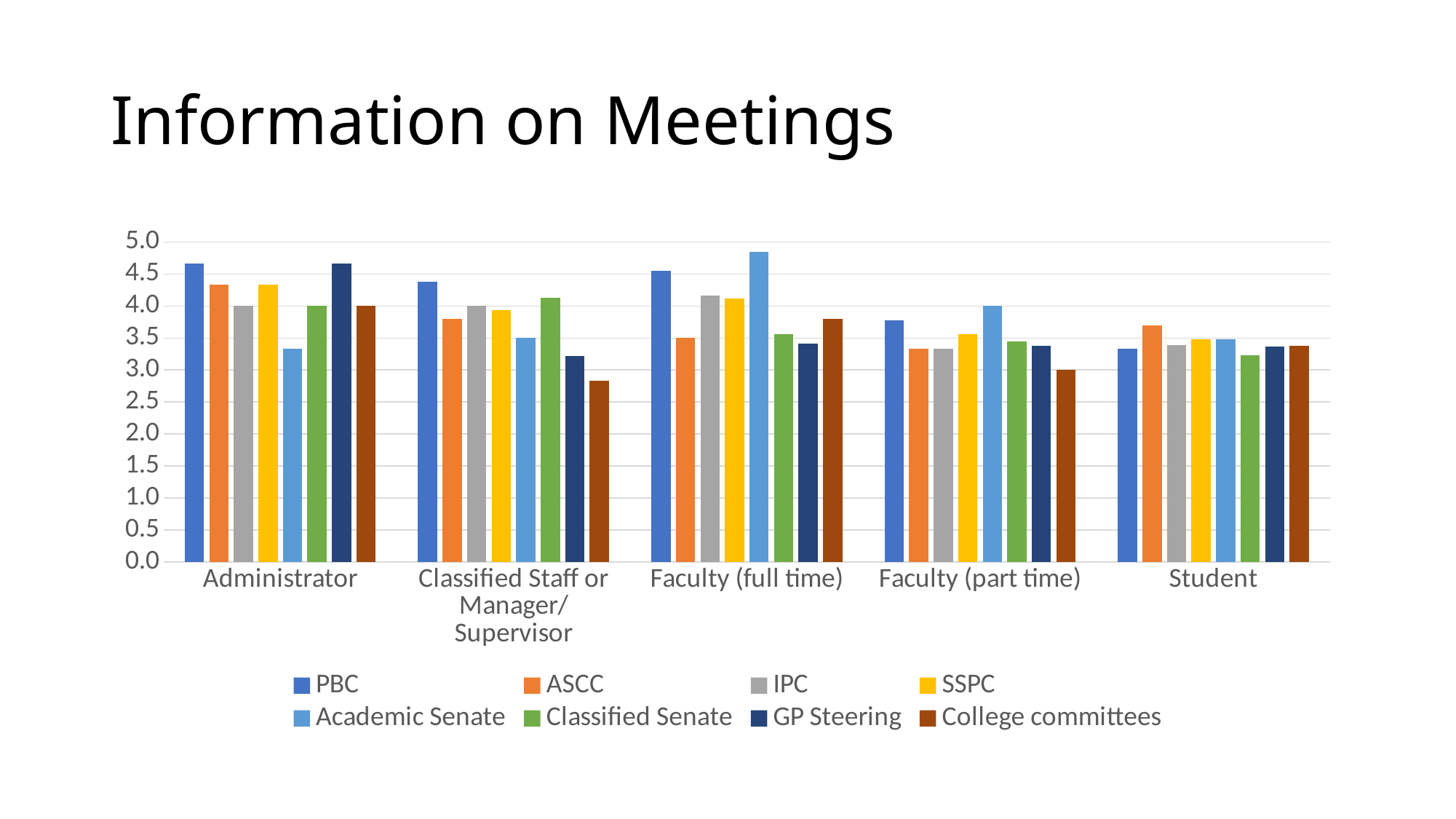
What kind of chart is shown on the slide? bar chart Is the value for College committees in the Classified Staff or Manager/Supervisor category greater or less than 3.0? less How many categories are shown along the x axis? 5 For Faculty (part time), which is larger: Academic Senate or College committees? Academic Senate For Administrator, which is larger: PBC or Academic Senate? PBC Is the value for PBC in the Faculty (full time) category greater or less than 4.0? greater Which series has the highest value for Faculty (full time)? Academic Senate What is the title of the slide? Information on Meetings Which series has the lowest value for Faculty (part time)? College committees Which series has the lowest value for Classified Staff or Manager/Supervisor? College committees How many series does the legend list? 8 Is the value for Academic Senate in the Administrator category greater or less than 3.5? less